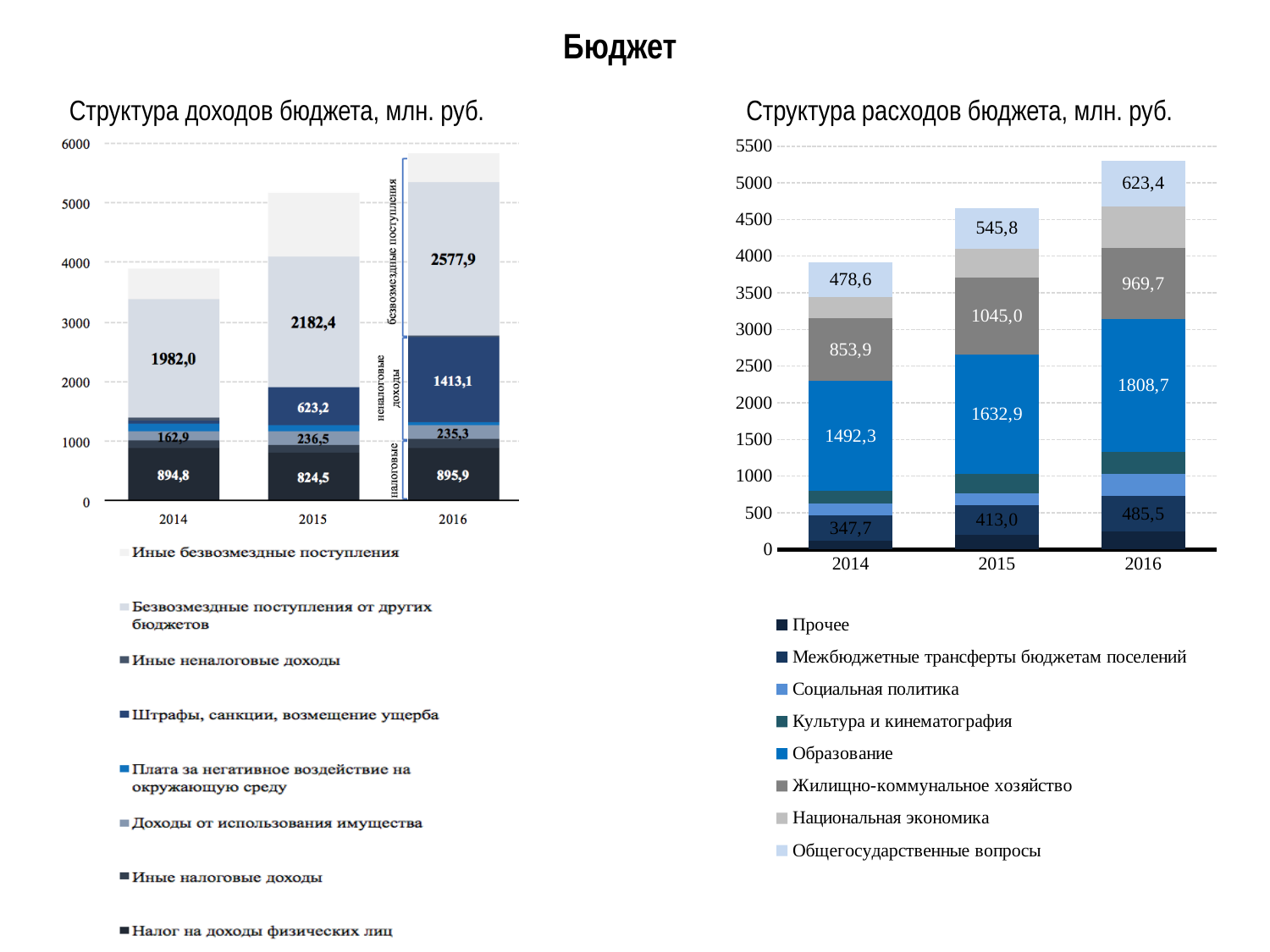
In the chart 'Структура расходов бюджета, млн. руб.', what is the value for Образование in 2016? 1808,7 In the chart 'Структура доходов бюджета, млн. руб.', what is the value of the bottom segment (Налог на доходы физических лиц) in 2015? 824,5 What kind of chart is 'Структура доходов бюджета, млн. руб.'? stacked bar chart How many series does the legend of the chart 'Структура расходов бюджета, млн. руб.' list? 8 In the chart 'Структура расходов бюджета, млн. руб.', what is the value for Общегосударственные вопросы in 2014? 478,6 In the chart 'Структура расходов бюджета, млн. руб.', what is the value for Жилищно-коммунальное хозяйство in 2015? 1045,0 How many years are shown on the x axis of the chart 'Структура доходов бюджета, млн. руб.'? 3 In the chart 'Структура расходов бюджета, млн. руб.', does the value for Образование rise or fall from 2014 to 2016? rises In the chart 'Структура расходов бюджета, млн. руб.', in which year is the value for Жилищно-коммунальное хозяйство the highest? 2015 In the chart 'Структура расходов бюджета, млн. руб.', what is the value for Межбюджетные трансферты бюджетам поселений in 2015? 413,0 In the chart 'Структура расходов бюджета, млн. руб.', is the total height of the 2016 bar greater or less than 5000? greater In the chart 'Структура расходов бюджета, млн. руб.', by how much did the value for Образование increase from 2014 to 2016? 316,4